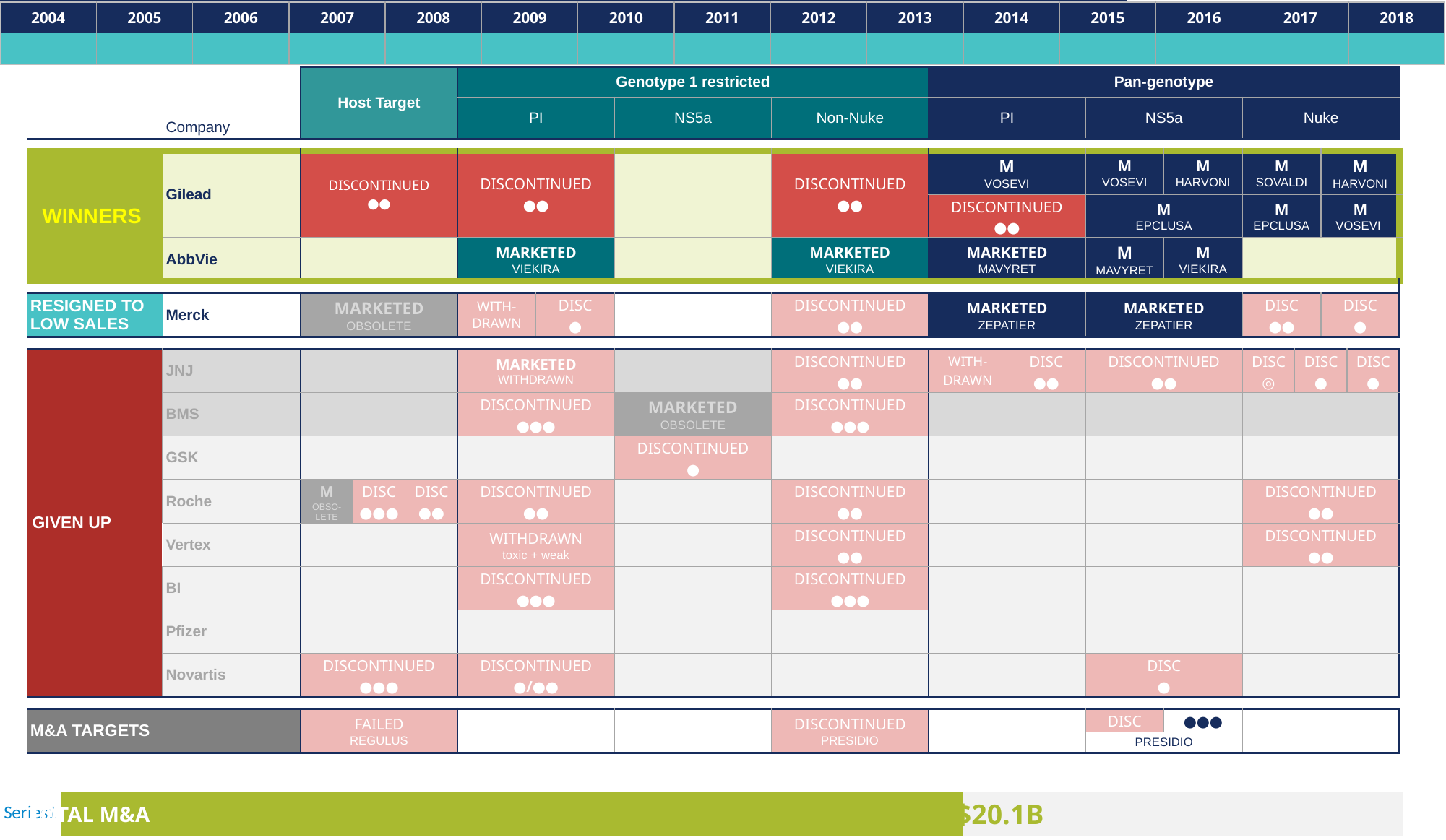
What kind of chart is shown at the bottom of the slide? bar chart What colour is the TOTAL M&A bar at the bottom of the slide? green How many bars does the chart at the bottom of the slide contain? 2 What label is written on the bar at the bottom of the slide? TOTAL M&A What value is printed on the TOTAL M&A bar at the bottom of the slide? $20.1B